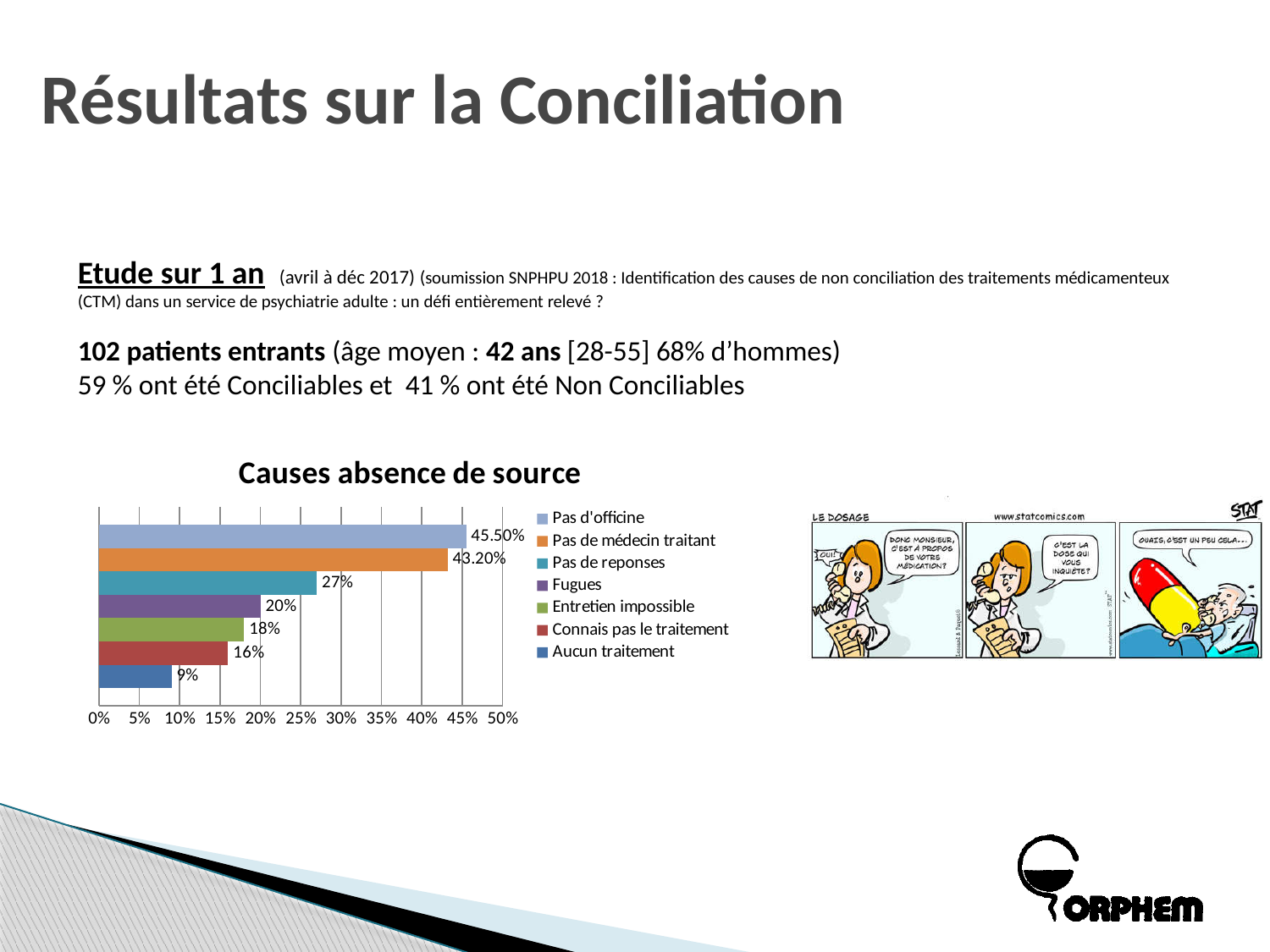
What is the difference between the values for "Pas de reponses" and "Entretien impossible"? 9% Which category has the highest value in the chart? Pas d'officine Which category has the lowest value in the chart? Aucun traitement How many bars are plotted in the chart? 7 What is the title of the chart on the slide? Causes absence de source How many entries does the chart's legend list? 7 What is the value for "Pas de médecin traitant" in the chart? 43.20% What kind of chart is shown under the title "Causes absence de source"? bar chart What is the value for "Pas d'officine" in the chart? 45.50% What is the value for "Fugues" in the chart? 20% What is the value for "Aucun traitement" in the chart? 9% Which is larger, the value for "Fugues" or the value for "Connais pas le traitement"? Fugues